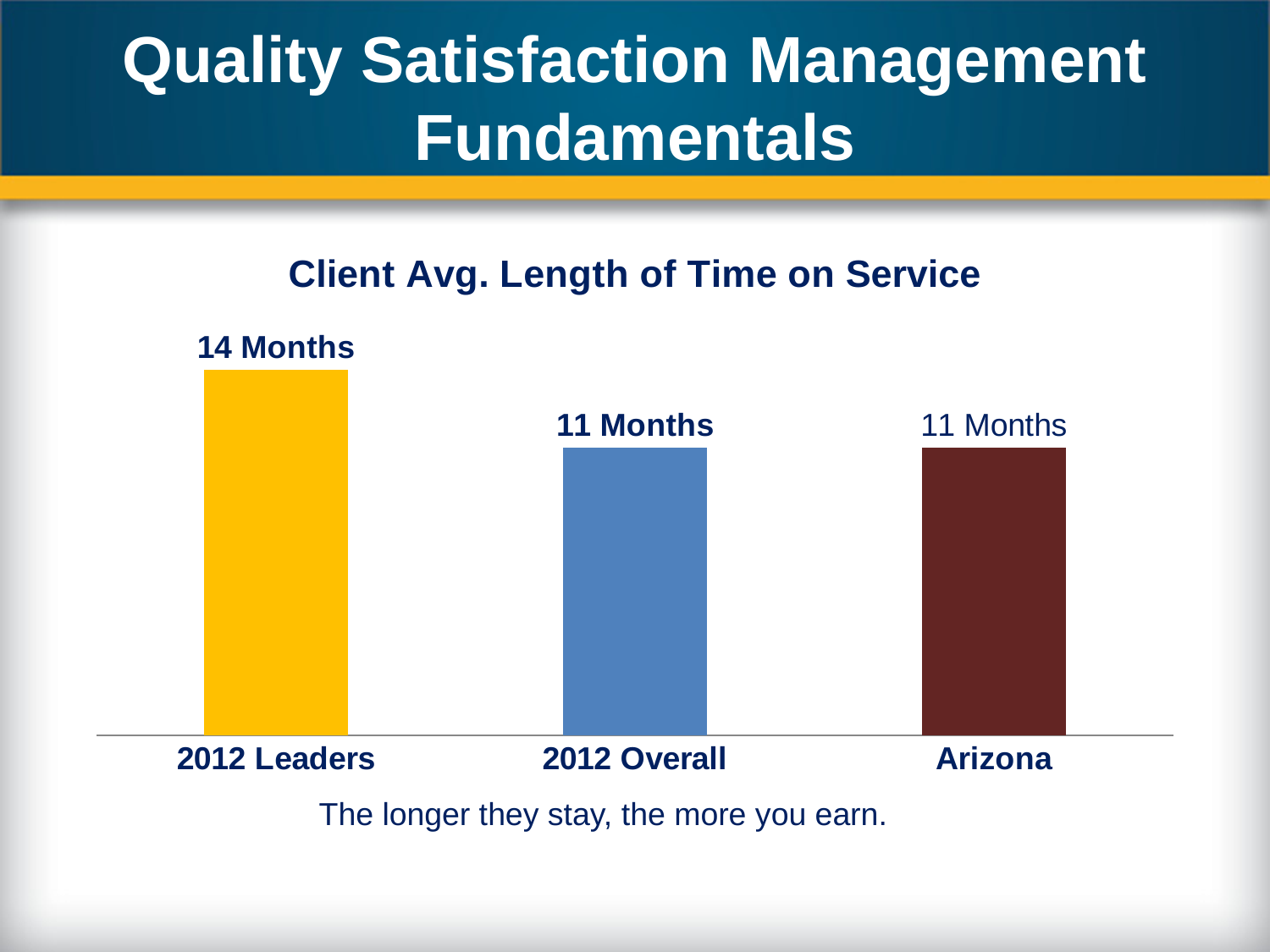
Which is larger, the value for 2012 Leaders or the value for Arizona? 2012 Leaders What is the value for Arizona? 11 Months What colour is the bar for 2012 Leaders? yellow What kind of chart is shown on the slide? bar chart Are the values for 2012 Overall and Arizona the same or different? the same What is the difference between the values for 2012 Leaders and 2012 Overall? 3 Months Which category has the highest value? 2012 Leaders How many categories are shown in the chart? 3 What is the value for 2012 Overall? 11 Months What is the title of the chart? Client Avg. Length of Time on Service What is the value for 2012 Leaders? 14 Months